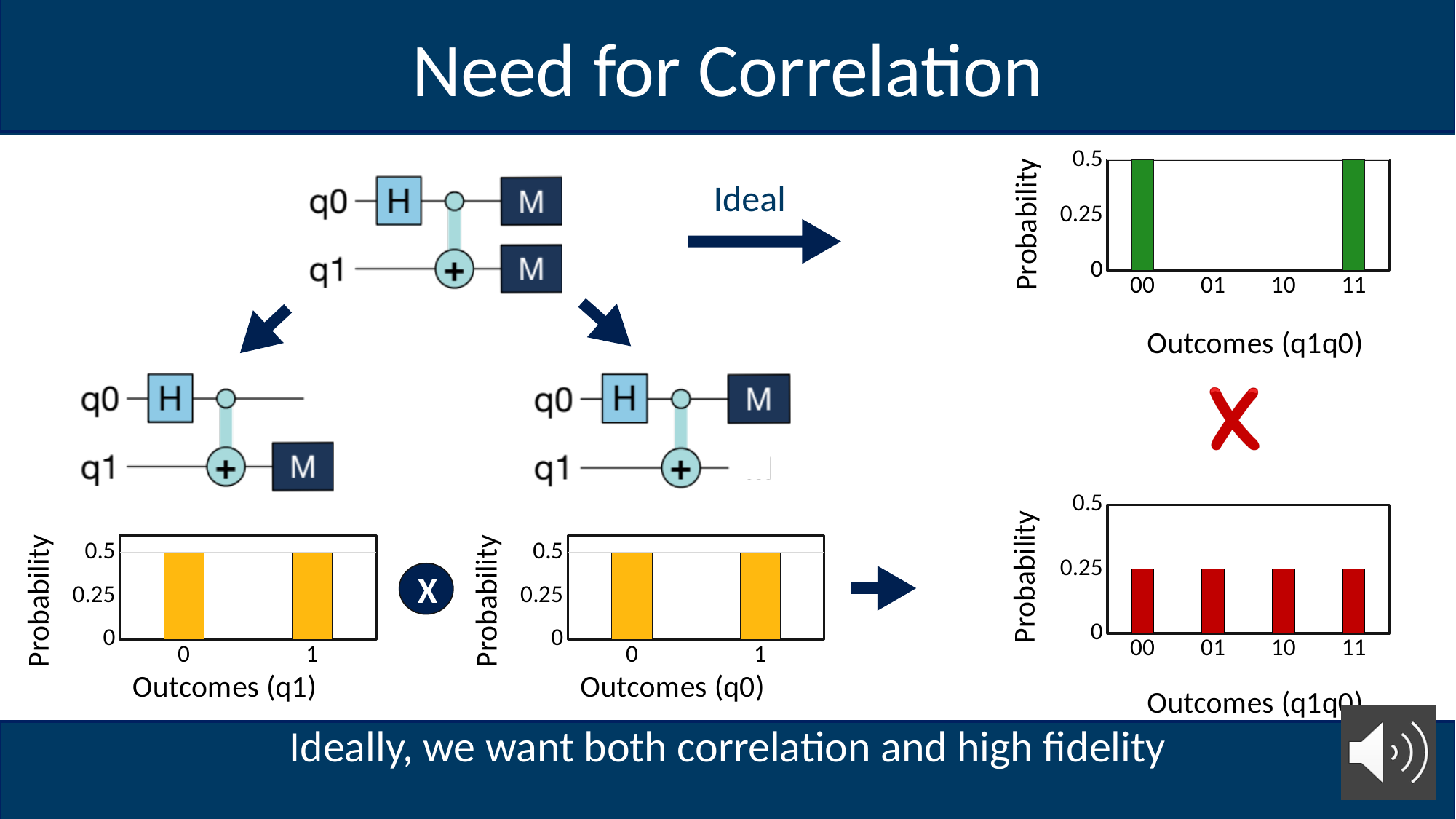
In the bottom-middle chart (Outcomes (q0)), how many outcome categories are shown on the x axis? 2 In the bottom-right chart (red bars), what is the total of the probabilities for all four outcomes? 1 In the bottom-right chart (red bars, Outcomes (q1q0)), how many outcome categories are shown on the x axis? 4 What type of chart is the top-right chart with green bars? bar chart In the bottom-left chart (Outcomes (q1)), what is the probability for outcome 1? 0.5 In the top-right chart (green bars), which is larger: the probability for outcome 11 or for outcome 10? 11 What is the y-axis label of the bottom-left chart (Outcomes (q1))? Probability In the top-right chart (green bars, Outcomes (q1q0)), what is the probability for outcome 00? 0.5 In the top-right chart (green bars), what is the difference between the probability for outcome 00 and the probability for outcome 01? 0.5 In the bottom-right chart (red bars, Outcomes (q1q0)), what is the probability for outcome 10? 0.25 In the top-right chart (green bars, Outcomes (q1q0)), what is the probability for outcome 01? 0 What colour are the bars in the bottom-middle chart (Outcomes (q0))? Yellow